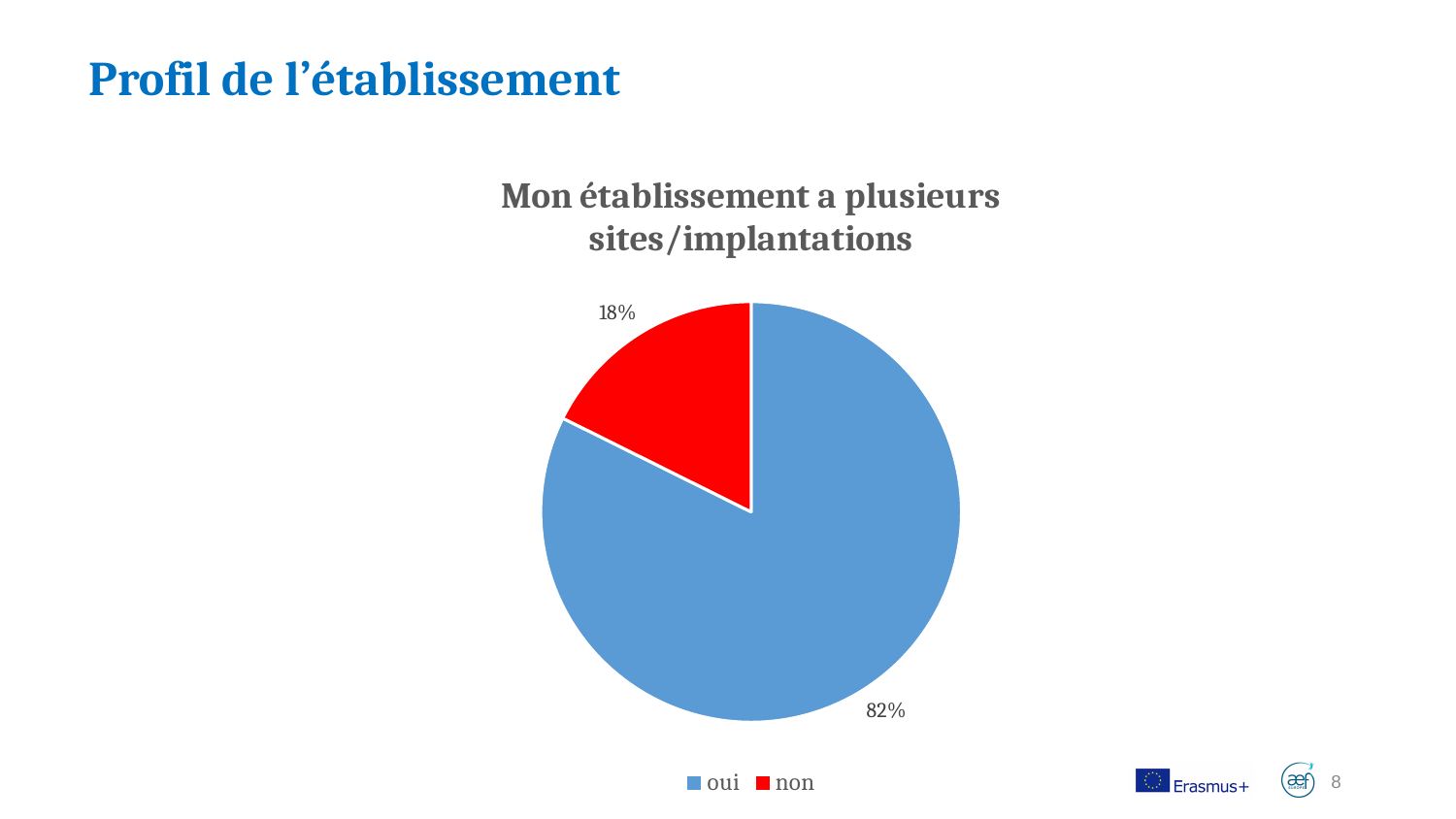
What is the difference in percentage points between the "oui" and "non" slices? 64 What colour is the "non" slice? red How many slices does the pie chart have? 2 What share of the pie is labelled "oui"? 82% What kind of chart is shown on the slide? pie chart What share of the pie is labelled "non"? 18% Which is larger, the "oui" slice or the "non" slice? oui Which slice is the largest? oui How many entries does the legend list? 2 Which slice is the smallest? non What is the title of the chart? Mon établissement a plusieurs sites/implantations